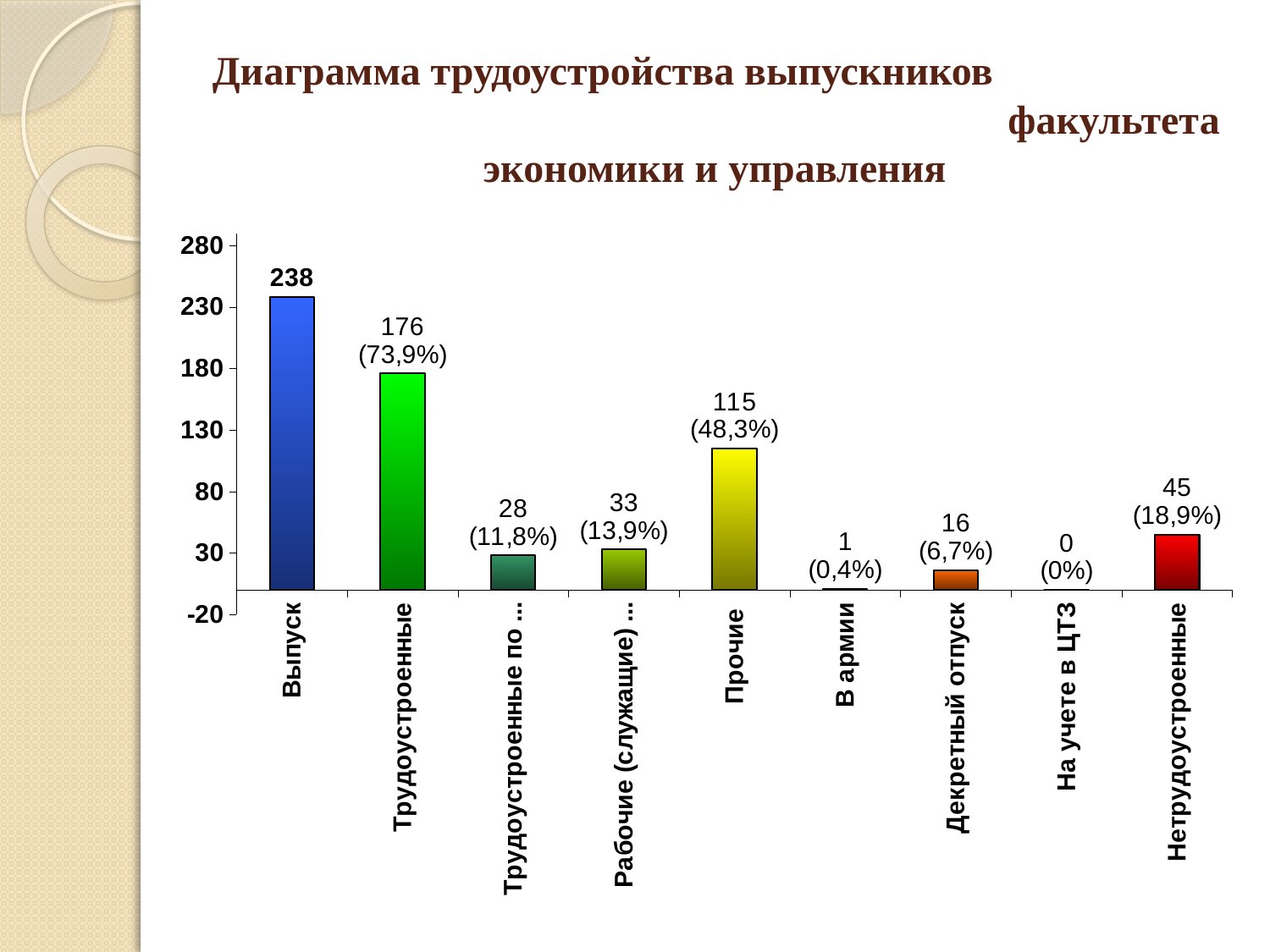
What is the difference between the values for Выпуск and Трудоустроенные? 62 What kind of chart is shown on the slide? Bar chart What is the value for Трудоустроенные? 176 What is the value for Декретный отпуск? 16 What percentage is shown for Нетрудоустроенные? 18,9% What is the value for На учете в ЦТЗ? 0 How many categories are shown on the x axis? 9 Which category has the highest value? Выпуск What percentage is shown for В армии? 0,4% Which category has the lowest value? На учете в ЦТЗ Which is larger, the value for Прочие or the value for Нетрудоустроенные? Прочие What is the value for Выпуск? 238